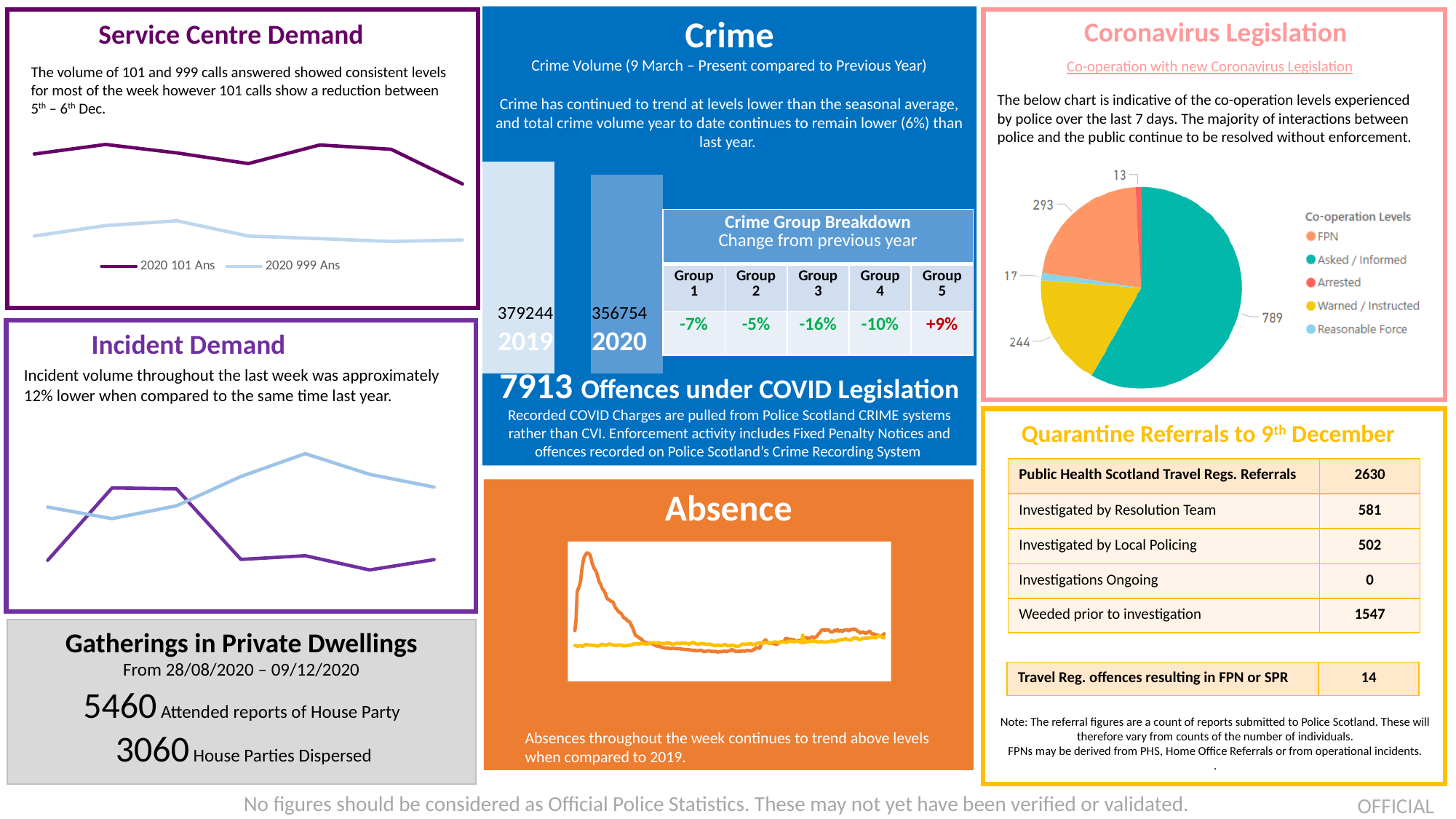
In the Crime chart, what kind of chart is used to compare 2019 and 2020 crime volume? bar chart In the Crime chart, what is the crime volume shown for 2019? 379244 In the Coronavirus Legislation pie chart, which co-operation level has the largest slice? Asked / Informed In the Coronavirus Legislation pie chart, how many co-operation levels are listed in the legend? 5 In the Crime chart, which year has the higher crime volume, 2019 or 2020? 2019 In the Coronavirus Legislation pie chart, what is the value for Asked / Informed? 789 In the Coronavirus Legislation pie chart, what is the difference between the FPN value and the Warned / Instructed value? 49 In the Service Centre Demand chart, which series is plotted higher, 2020 101 Ans or 2020 999 Ans? 2020 101 Ans In the Coronavirus Legislation pie chart, which co-operation level has the smallest slice? Arrested In the Crime chart, what is the crime volume shown for 2020? 356754 In the Crime chart, what is the difference between the 2019 and 2020 crime volumes? 22490 In the Service Centre Demand chart, how many series does the legend list? 2